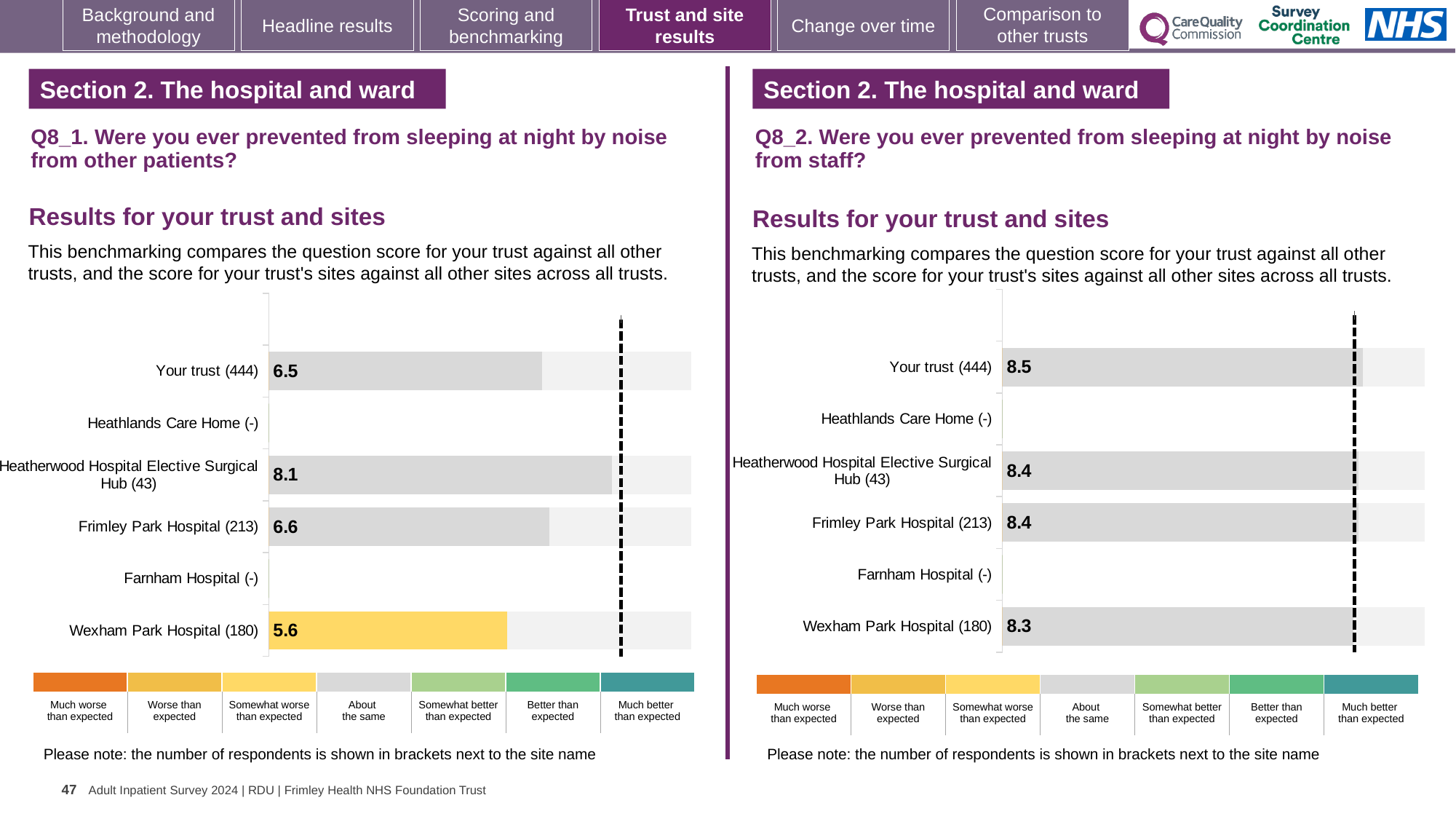
On the Q8_2 chart (right), what is the difference between the scores for Your trust (444) and Wexham Park Hospital (180)? 0.2 On the Q8_1 chart (left), what is the score for Your trust (444)? 6.5 On the Q8_2 chart (right), what is the score for Frimley Park Hospital (213)? 8.4 On the Q8_2 chart (right), what is the score for Your trust (444)? 8.5 On the Q8_2 chart (right), what is the score for Wexham Park Hospital (180)? 8.3 On the Q8_1 chart (left), what is the score for Wexham Park Hospital (180)? 5.6 On the Q8_1 chart (left), which site has the highest score? Heatherwood Hospital Elective Surgical Hub (43) What kind of chart is the Q8_2 chart (right)? Bar chart On the Q8_1 chart (left), which site has the lowest score? Wexham Park Hospital (180) How many site/trust categories are listed on the Q8_1 chart (left)? 6 On the Q8_1 chart (left), which is larger: the score for Frimley Park Hospital (213) or Your trust (444)? Frimley Park Hospital (213) On the Q8_1 chart (left), what is the difference between the scores for Heatherwood Hospital Elective Surgical Hub (43) and Frimley Park Hospital (213)? 1.5